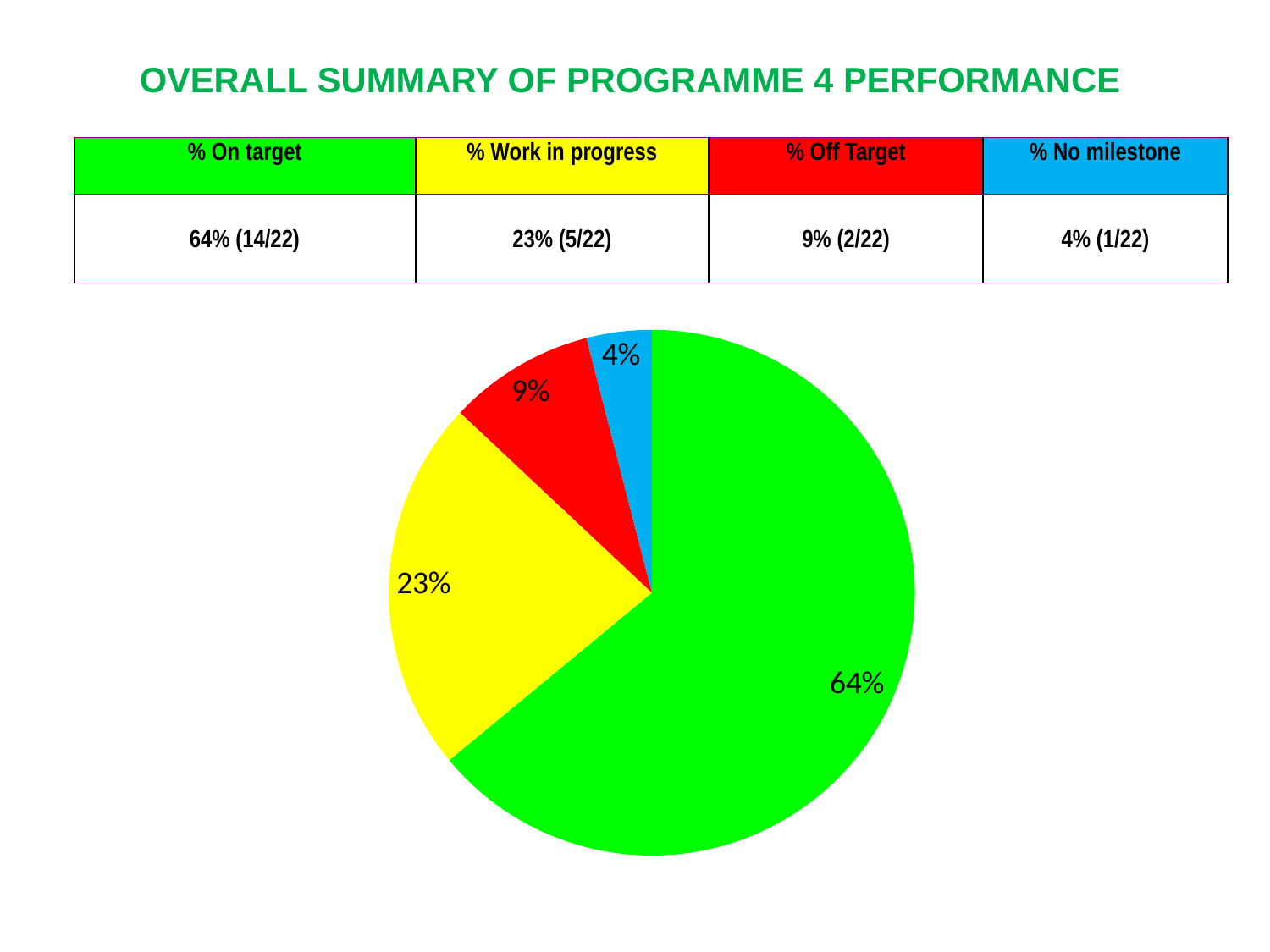
What share of the pie does the red (Off Target) slice represent? 9% What is the difference in percentage points between the On target slice and the Work in progress slice? 41 What kind of chart is shown on the slide? pie chart What is the difference in percentage points between the Off Target slice and the No milestone slice? 5 What colour is the slice representing Work in progress? yellow Which category has the smallest slice of the pie? No milestone How many slices does the pie chart have? 4 What share of the pie does the blue (No milestone) slice represent? 4% Which category has the largest slice of the pie? On target Which is larger, the Off Target slice or the No milestone slice? Off Target What share of the pie does the green (On target) slice represent? 64%